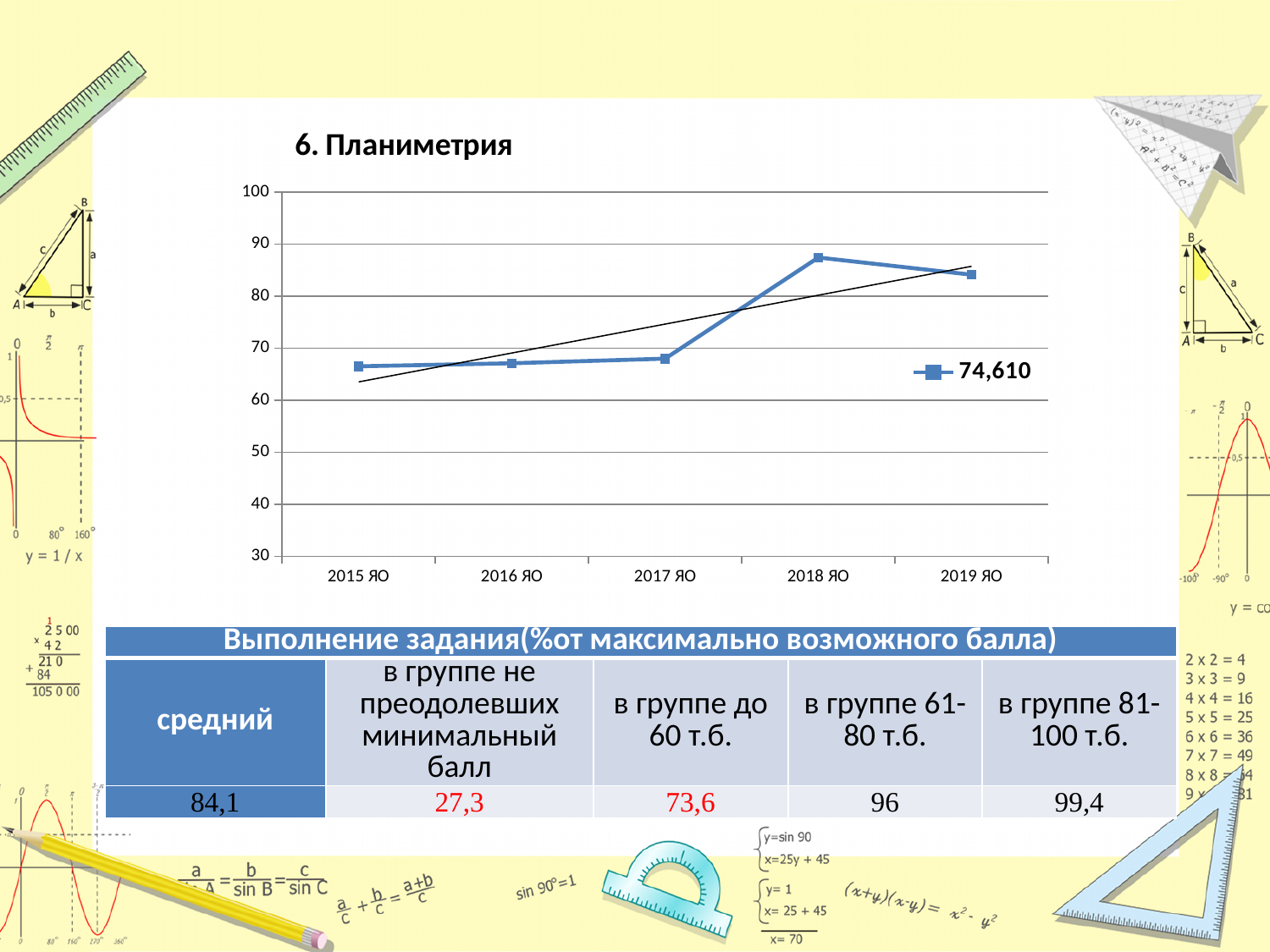
How many series does the chart legend list? 1 Do the values generally rise or fall from 2015 ЯО to 2018 ЯО? rise Which is larger, the value for 2017 ЯО or the value for 2018 ЯО? 2018 ЯО Is the value for 2018 ЯО greater or less than 80? greater What is the title of the chart? 6. Планиметрия Which is larger, the value for 2018 ЯО or the value for 2019 ЯО? 2018 ЯО Is the value for 2019 ЯО greater or less than 90? less How many data points are plotted along the x axis of the chart? 5 Which year has the highest value on the chart? 2018 ЯО What is the legend entry shown for the plotted series? 74,610 Is the value for 2015 ЯО greater or less than 70? less What kind of chart is shown on the slide? line chart